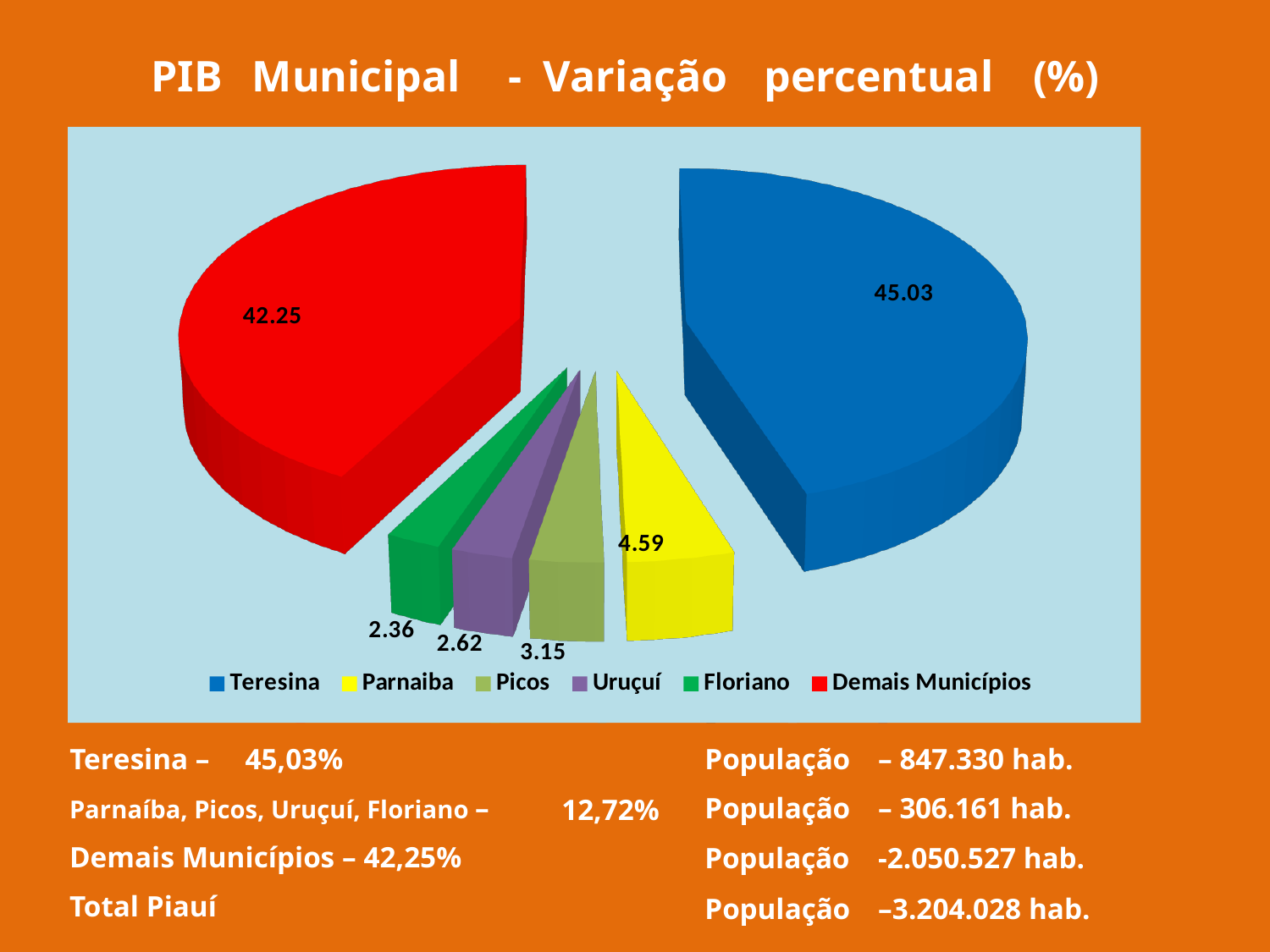
What value is shown for Parnaiba in the pie chart? 4.59 What value is shown for Uruçuí in the pie chart? 2.62 What value is shown for Demais Municípios in the pie chart? 42.25 What is the difference between the values for Parnaiba and Picos? 1.44 How many slices does the pie chart have? 6 Which category has the largest slice in the pie chart? Teresina What kind of chart is shown on the slide? Pie chart What is the difference between the values for Teresina and Demais Municípios? 2.78 Which category has the smallest slice in the pie chart? Floriano What value is shown for Teresina in the pie chart? 45.03 What colour is the slice for Demais Municípios? Red Which is larger, the value for Picos or the value for Floriano? Picos